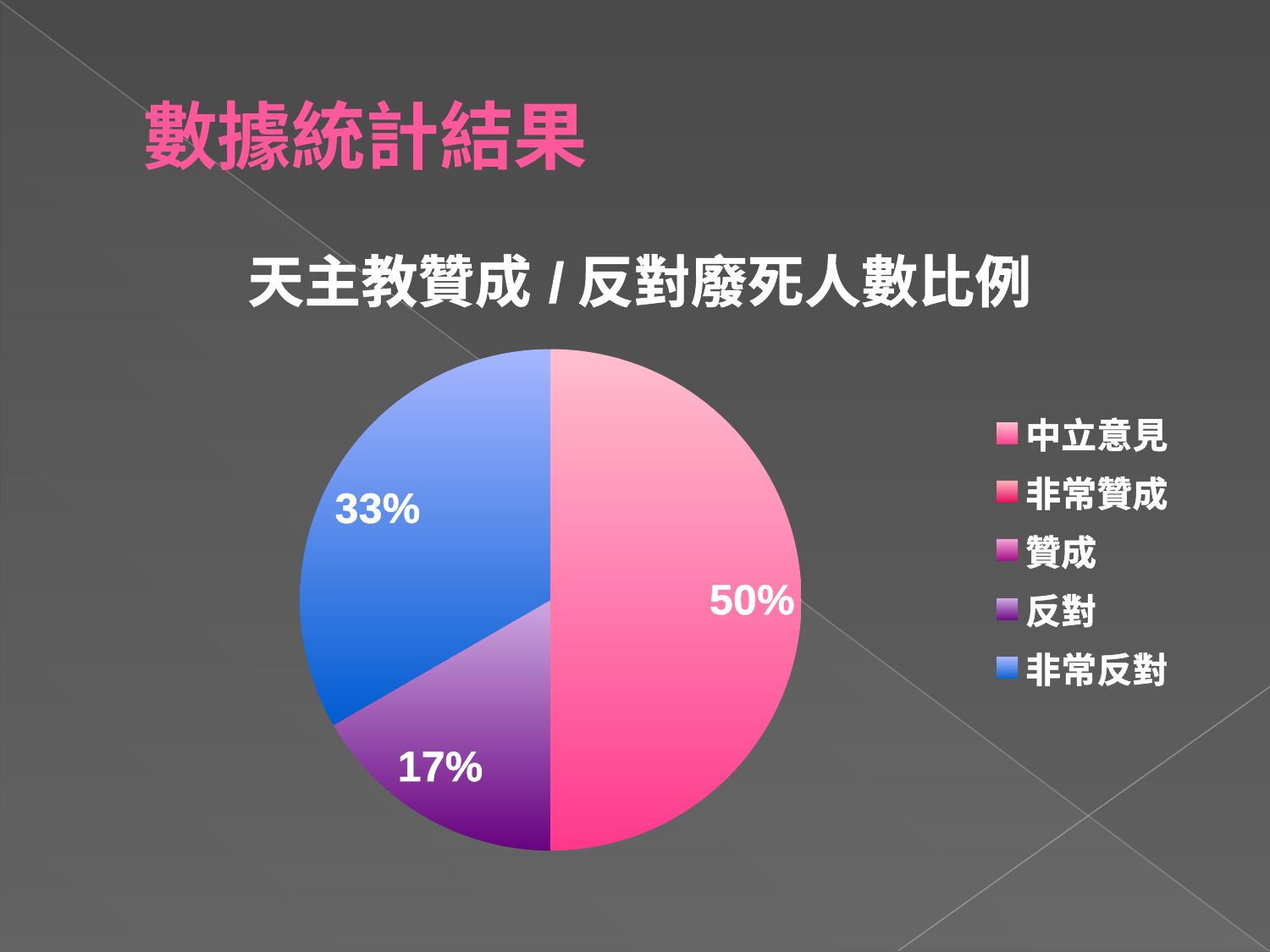
What percentage of the pie is labelled for 反對? 17% How many slices of the pie have a percentage label? 3 Which category has the largest slice of the pie? 中立意見 How many categories does the legend list? 5 What is the difference in percentage points between the 中立意見 slice and the 非常反對 slice? 17% What is the difference in percentage points between the 非常反對 slice and the 反對 slice? 16% What percentage of the pie is labelled for 非常反對? 33% What percentage of the pie is labelled for 中立意見? 50% Which of the labelled slices is the smallest? 反對 What is the title of the chart? 天主教贊成 / 反對廢死人數比例 What kind of chart is shown on the slide? pie chart Which slice is larger, 非常反對 or 反對? 非常反對